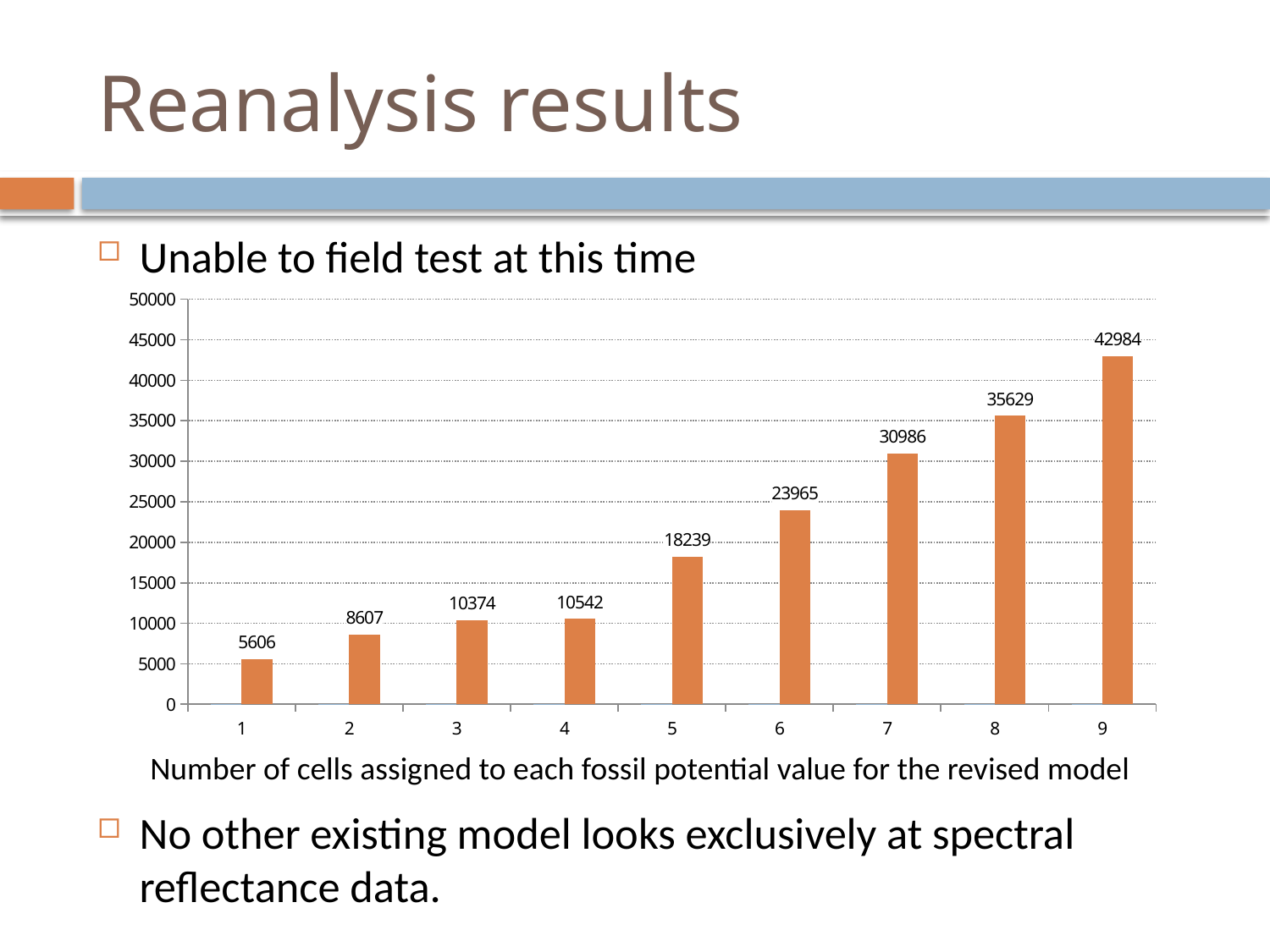
What is the value for category 1? 5606 How many categories are shown on the x axis? 9 What is the difference between the values for category 4 and category 3? 168 What is the value for category 5? 18239 What kind of chart is shown on the slide? bar chart What is the difference between the values for category 9 and category 8? 7355 Is the value for category 7 greater or less than 30000? greater Which is larger, the value for category 6 or the value for category 7? 7 What is the value for category 8? 35629 Which category has the highest value? 9 Do the values rise or fall from category 1 to category 9? rise Which category has the lowest value? 1